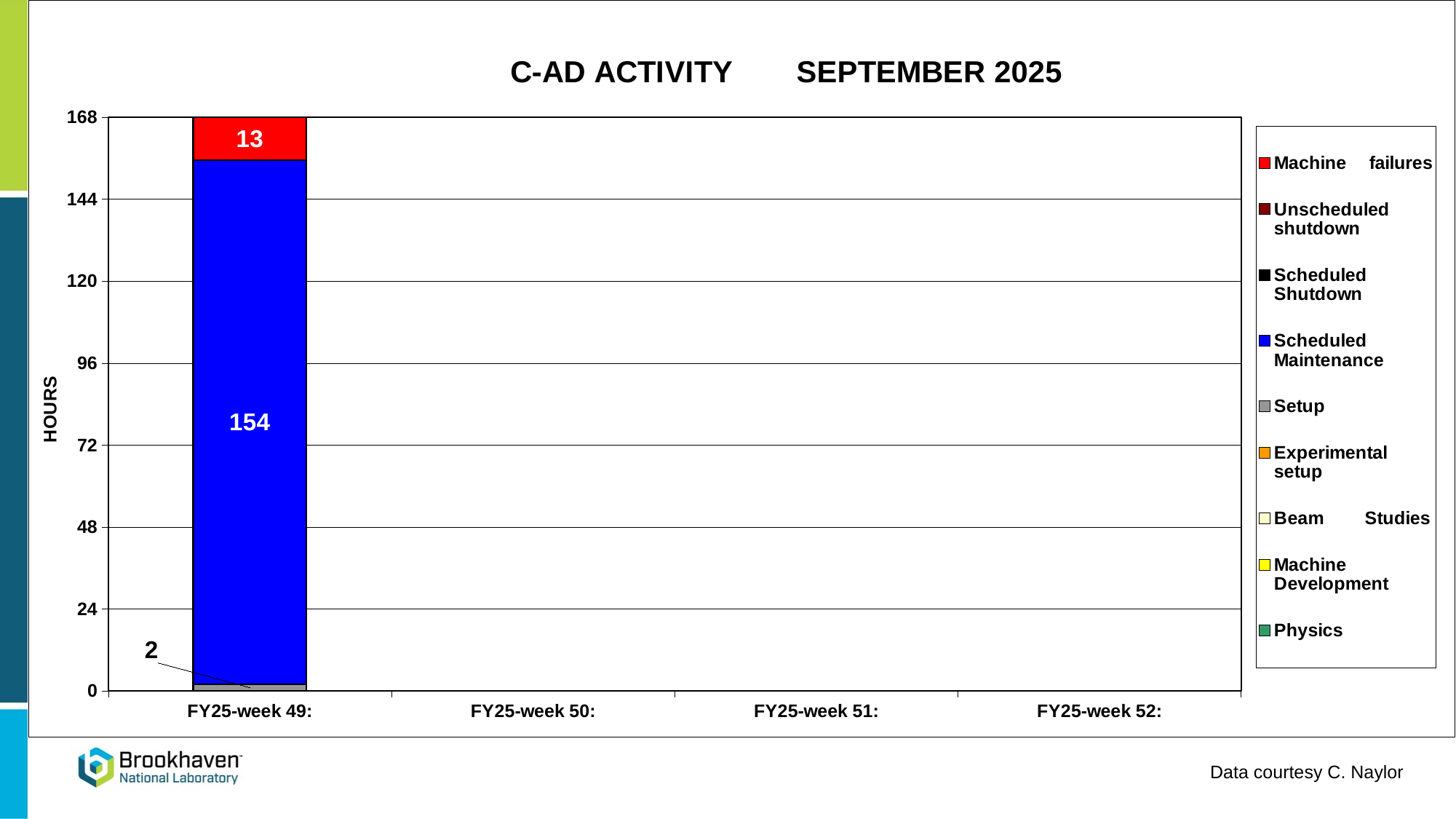
What is the value for Machine failures in FY25-week 49? 13 Which series has the largest value in the FY25-week 49 bar? Scheduled Maintenance Is the value for Scheduled Maintenance in FY25-week 49 greater or less than 144? greater How many categories are shown on the x axis? 4 Which is larger in FY25-week 49, Machine failures or Setup? Machine failures What is the difference between the Scheduled Maintenance and Machine failures values in FY25-week 49? 141 How many series does the legend list? 9 What is the value for Scheduled Maintenance in FY25-week 49? 154 What is the value for Setup in FY25-week 49? 2 What kind of chart is shown on the slide? Stacked bar chart Which series has the smallest labelled value in the FY25-week 49 bar? Setup What is the label of the y axis? HOURS